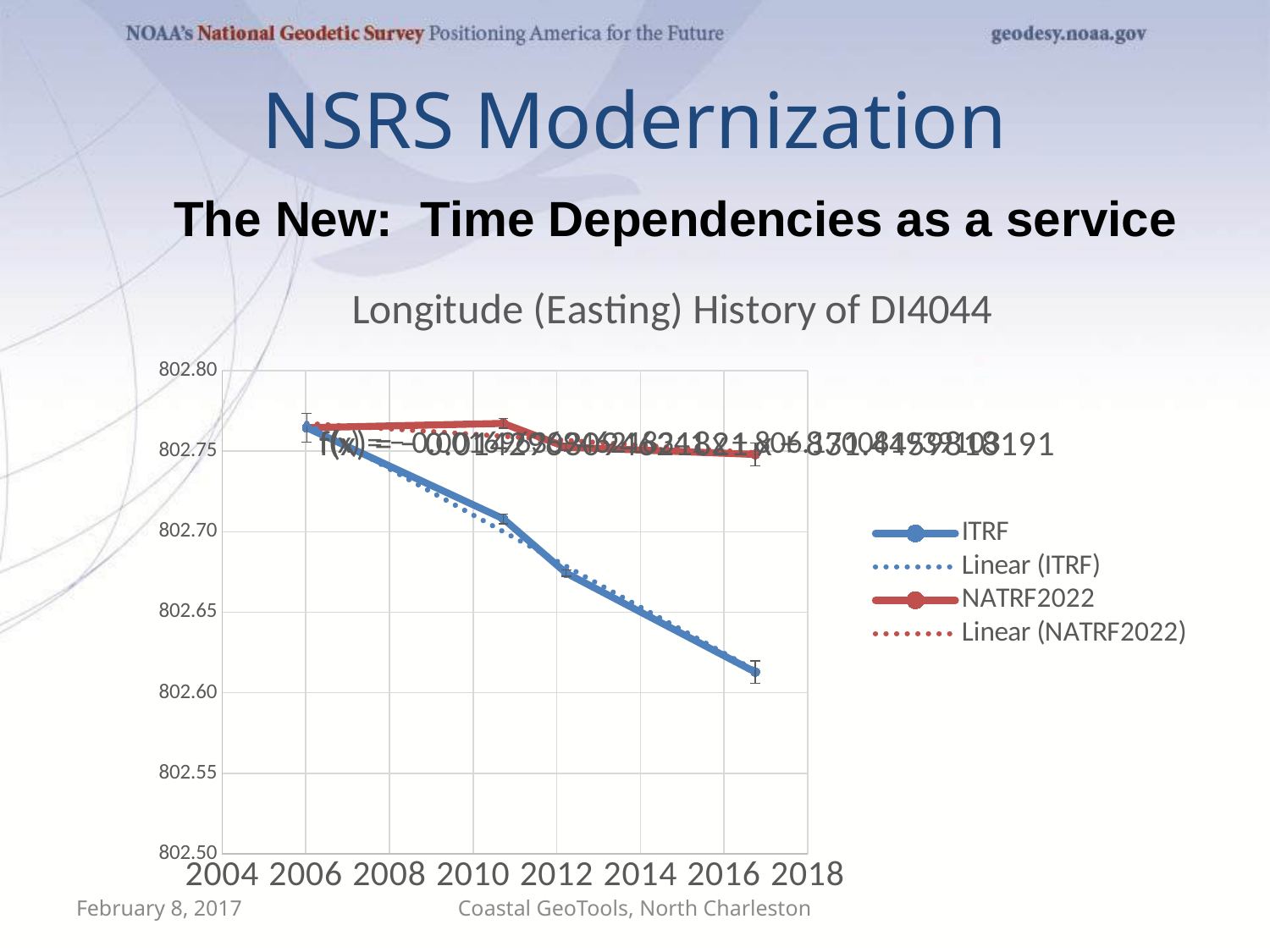
Is the ITRF value at the point between 2012 and 2014 greater or less than 802.70? less Is the ITRF value at the last point (around 2017) greater or less than 802.65? less Which series shows the larger decrease over the period, ITRF or NATRF2022? ITRF Do the ITRF values rise or fall from 2006 to 2017? fall What is the title of the chart? Longitude (Easting) History of DI4044 How many entries does the chart legend list? 4 At the last point (around 2017), which series has the higher value, ITRF or NATRF2022? NATRF2022 Is the ITRF value at the first point (around 2006) greater or less than 802.75? greater Which two data series (excluding trendlines) are plotted in the chart? ITRF and NATRF2022 What is the lowest value shown on the vertical axis? 802.50 What kind of chart is shown on the slide? line chart